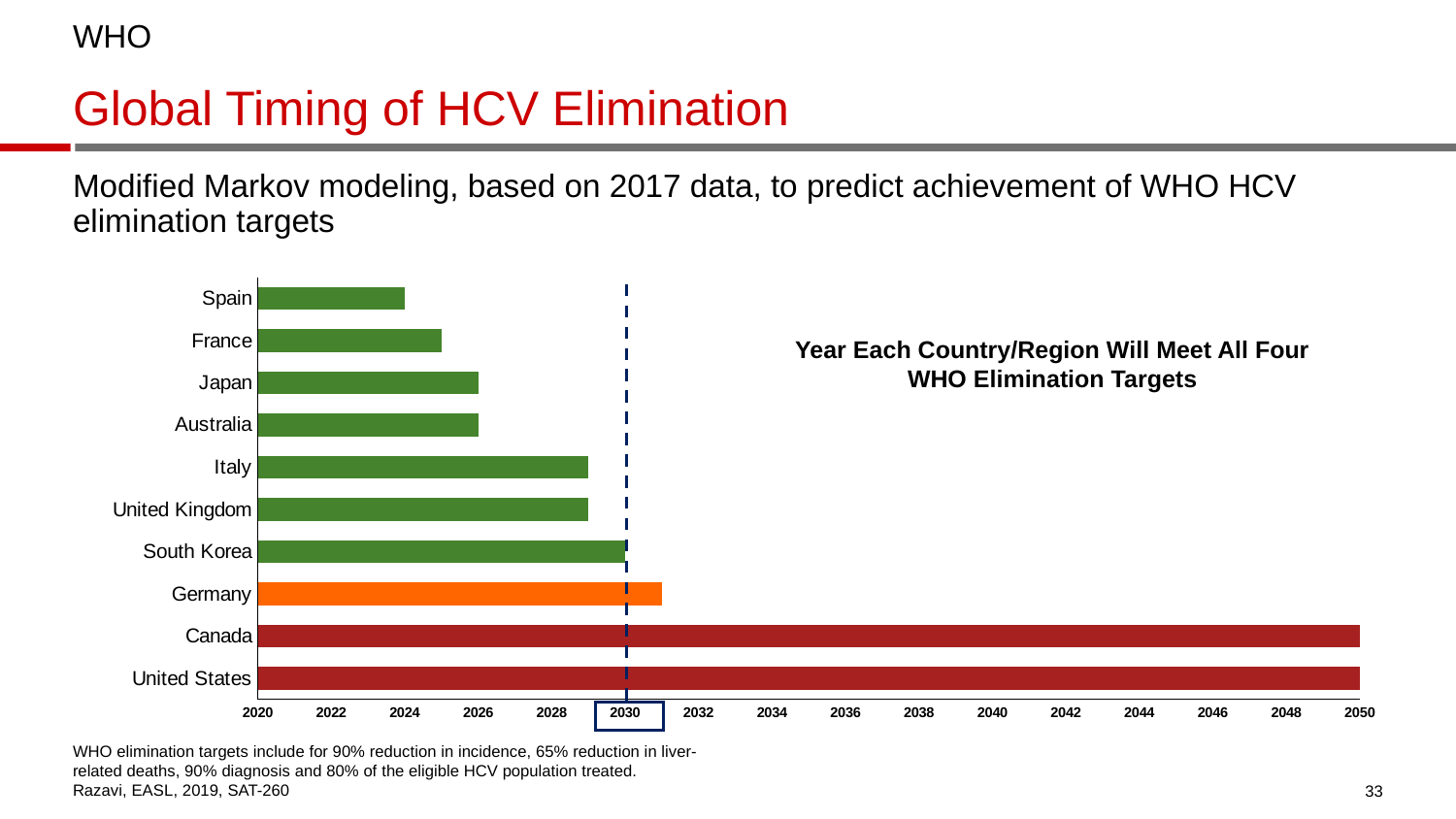
Is the value for France greater or less than 2026? less What year does the bar for South Korea end at? 2030 What year does the bar for Japan end at? 2026 Is the value for Germany greater or less than 2030? greater What year does the bar for Spain end at? 2024 What year does the bar for Canada end at? 2050 Which has a later year, Italy or Japan? Italy How many countries are shown in the chart? 10 Which country has the earliest (shortest bar) year for meeting all four WHO elimination targets? Spain Is the value for Italy greater or less than 2028? greater What kind of chart is shown on the slide? Bar chart What year does the vertical dashed line on the chart mark? 2030